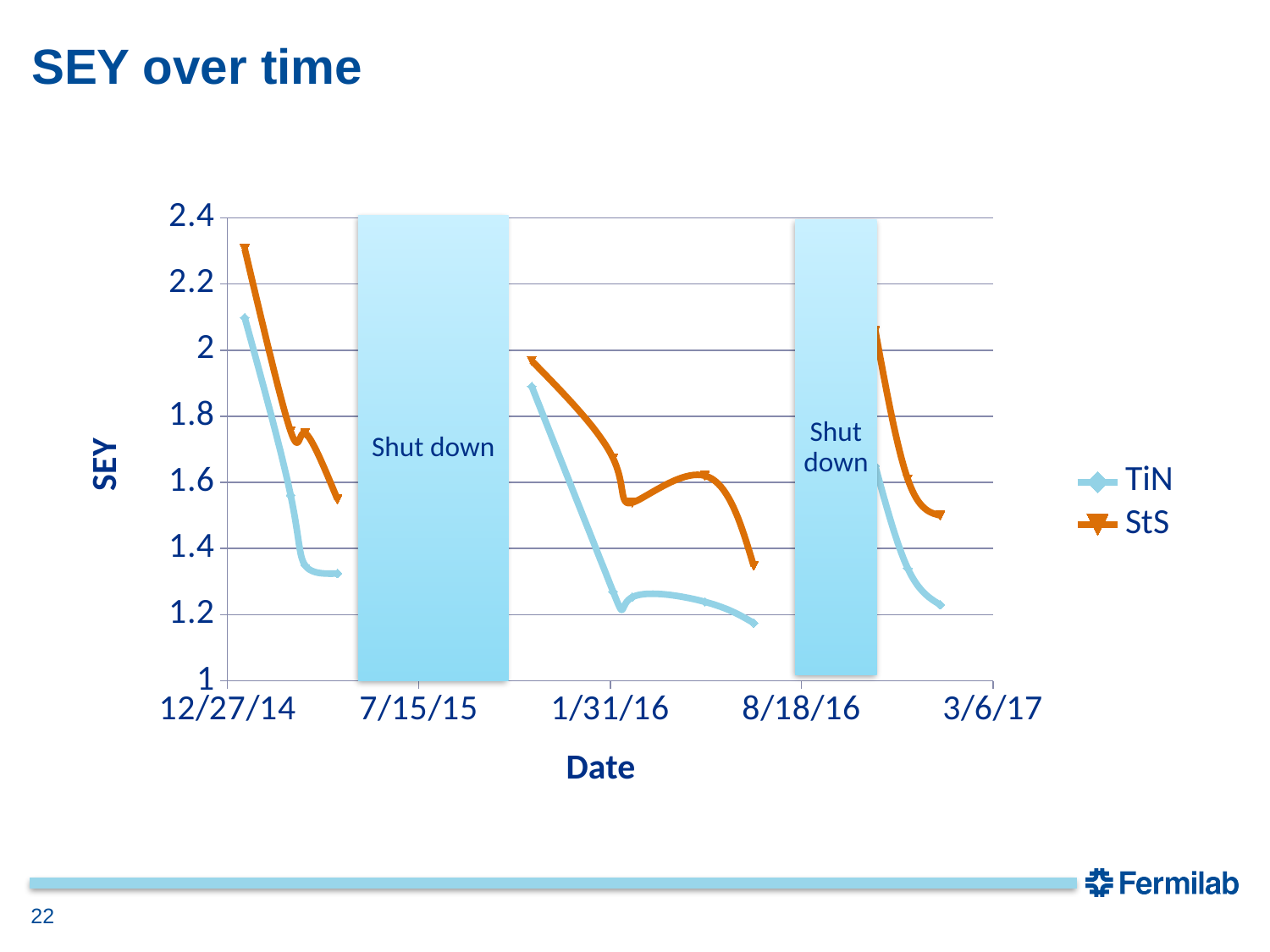
Does the SEY for TiN generally rise or fall over time within each measurement period? fall Is the first StS value near 12/27/14 greater or less than 2.2? greater Is the last StS value before the first shut down greater or less than 1.6? less Is the lowest TiN value, just before 8/18/16, greater or less than 1.2? less What are the two series named in the legend? TiN and StS Which series has the higher SEY values throughout the chart, TiN or StS? StS What kind of chart is shown on the slide? line chart What is the title of the chart? SEY over time How many series does the legend list? 2 How many shut down periods are marked on the chart? 2